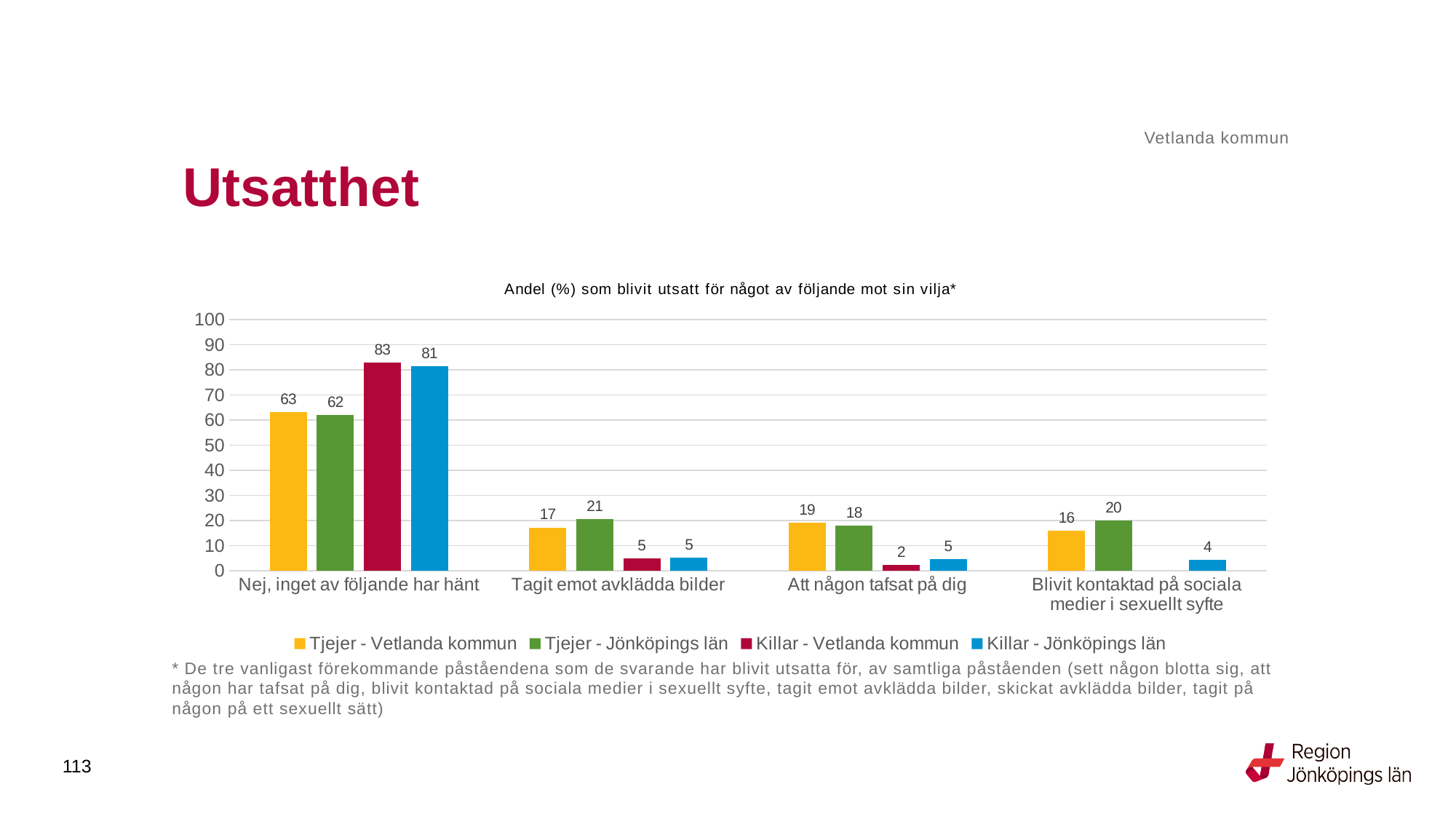
What type of chart is shown on the slide? Bar chart Is the value for Killar - Jönköpings län in the category 'Nej, inget av följande har hänt' greater or less than 70? greater Which series has the lowest value in the category 'Att någon tafsat på dig'? Killar - Vetlanda kommun How many series does the legend list? 4 What is the value for Killar - Vetlanda kommun in the category 'Nej, inget av följande har hänt'? 83 What is the title of the chart? Andel (%) som blivit utsatt för något av följande mot sin vilja* What is the difference between Tjejer - Vetlanda kommun and Killar - Vetlanda kommun in the category 'Nej, inget av följande har hänt'? 20 What is the value for Killar - Jönköpings län in the category 'Blivit kontaktad på sociala medier i sexuellt syfte'? 4 Which series has the highest value in the category 'Nej, inget av följande har hänt'? Killar - Vetlanda kommun How many categories are shown on the x axis? 4 What is the value for Tjejer - Jönköpings län in the category 'Tagit emot avklädda bilder'? 21 Which is larger in the category 'Blivit kontaktad på sociala medier i sexuellt syfte': Tjejer - Vetlanda kommun or Tjejer - Jönköpings län? Tjejer - Jönköpings län